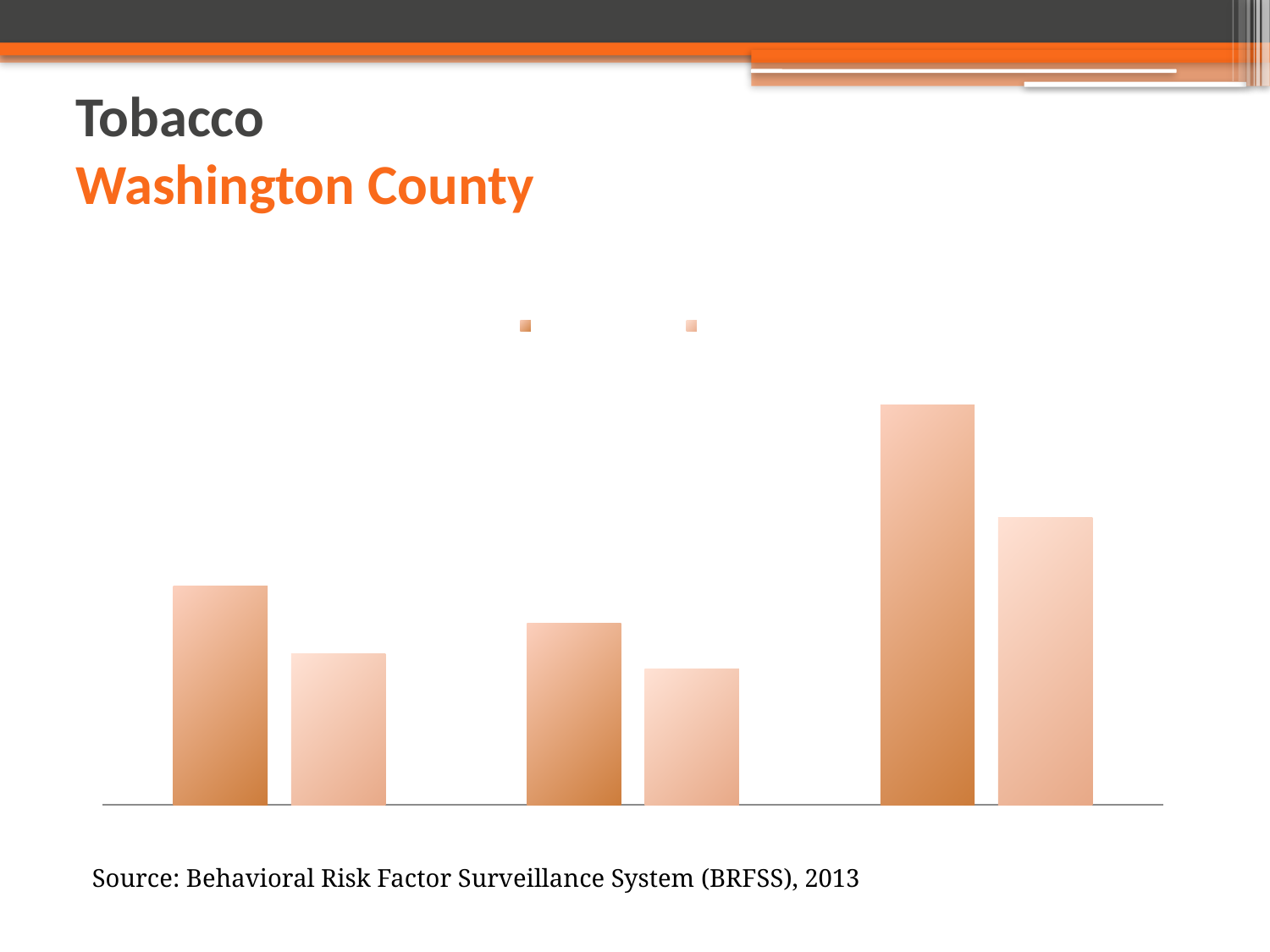
How many bars are plotted in total on the chart? 6 In the third group of bars, is the darker bar or the lighter bar taller? the darker bar Which group of bars, counting from the left, contains the shortest bar? the second group What data source is cited below the chart? Behavioral Risk Factor Surveillance System (BRFSS), 2013 Is the lighter bar in the second group taller or shorter than the lighter bar in the first group? shorter In the first group of bars, is the darker bar or the lighter bar taller? the darker bar How many series does the legend list? 2 How many groups of bars does the chart show? 3 Which group of bars, counting from the left, contains the tallest bar? the third group Do the darker bars rise steadily from left to right across the three groups? no What kind of chart is shown on the slide? bar chart